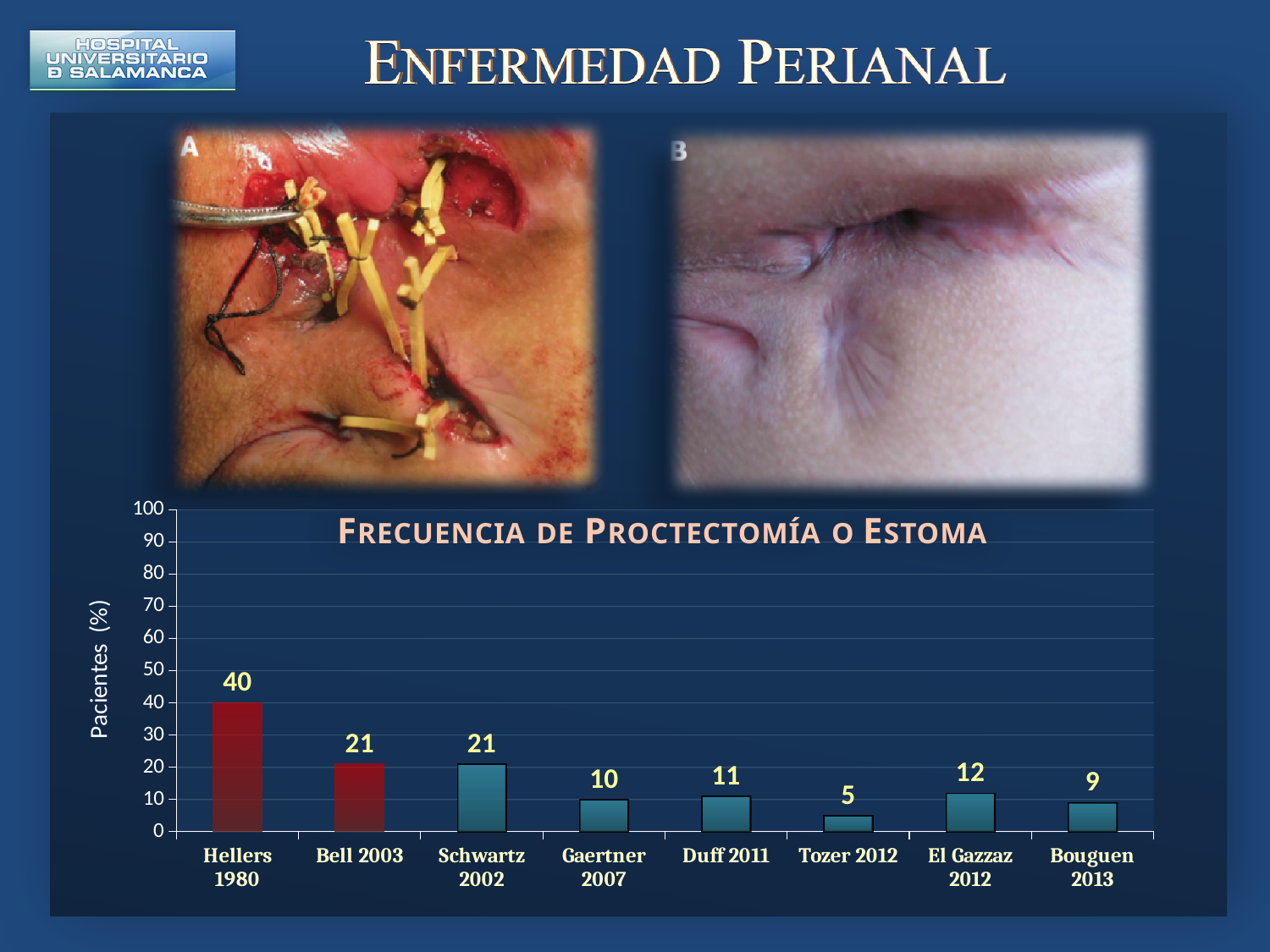
What is the value for Tozer 2012? 5 What kind of chart is shown on the slide? bar chart Which study has the lowest value? Tozer 2012 What is the difference between the values for El Gazzaz 2012 and Bouguen 2013? 3 How many studies are shown on the x axis? 8 Which is larger, the value for Gaertner 2007 or the value for Duff 2011? Duff 2011 What is the value for Hellers 1980? 40 Which study has the highest value? Hellers 1980 Is the value for Schwartz 2002 greater or less than 30? less What is the title of the chart? Frecuencia de Proctectomía o Estoma What is the difference between the values for Hellers 1980 and Bell 2003? 19 What is the value for El Gazzaz 2012? 12